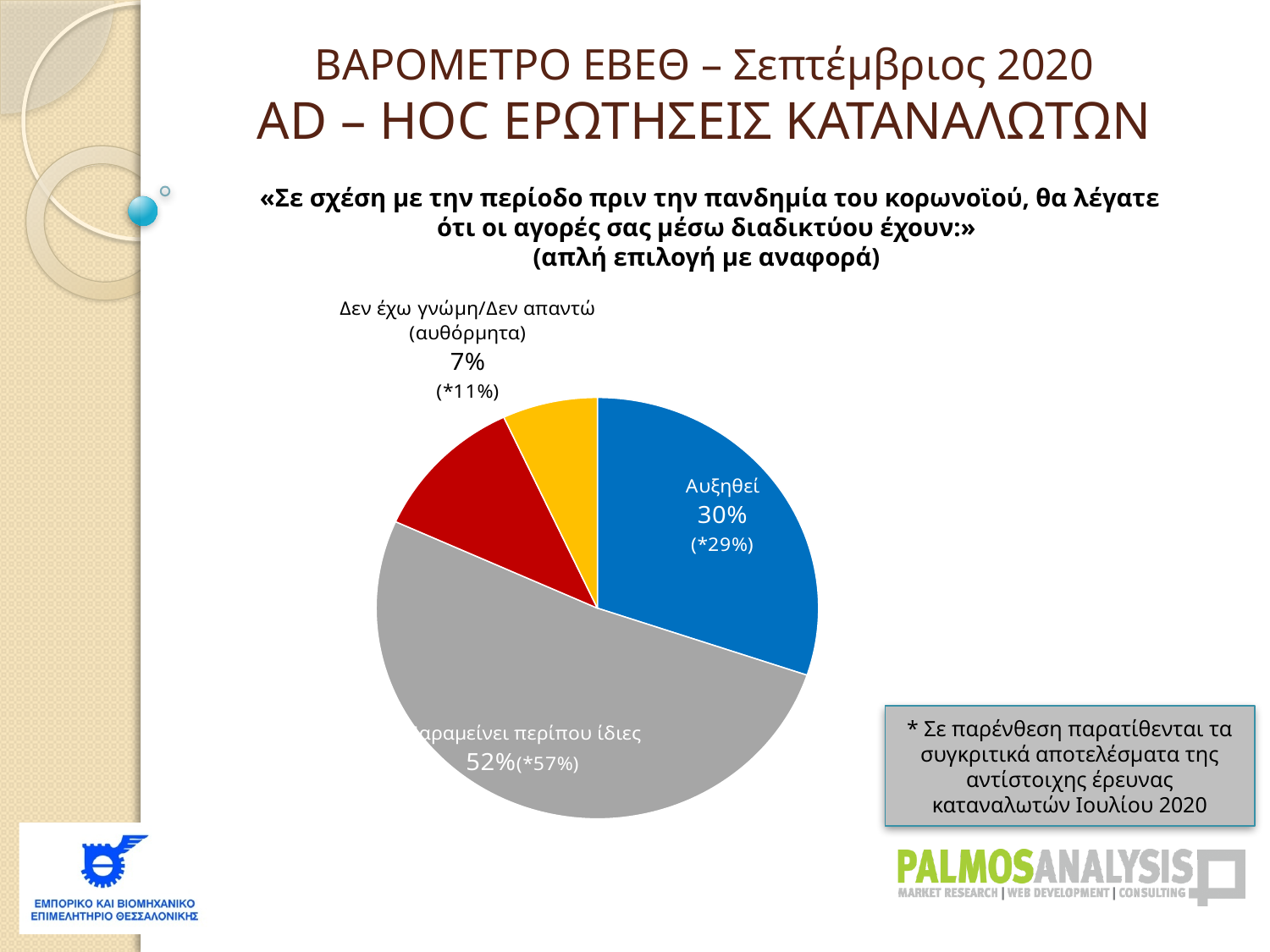
Which answer category has the largest share of the pie? Παραμείνει περίπου ίδιες What percentage of respondents answered «Παραμείνει περίπου ίδιες»? 52% By how many percentage points does «Παραμείνει περίπου ίδιες» exceed «Αυξηθεί»? 22 percentage points What percentage of respondents answered «Αυξηθεί» in the pie chart? 30% Which answer category has the smallest share of the pie? Δεν έχω γνώμη/Δεν απαντώ (αυθόρμητα) What kind of chart is shown on the slide? Pie chart What was the comparative July 2020 value shown in parentheses for «Παραμείνει περίπου ίδιες»? 57% What colour is the «Αυξηθεί» slice of the pie chart? Blue What was the comparative July 2020 value shown in parentheses for «Αυξηθεί»? 29% What was the comparative July 2020 value shown in parentheses for «Δεν έχω γνώμη/Δεν απαντώ (αυθόρμητα)»? 11% Which is larger: the share for «Αυξηθεί» or the share for «Δεν έχω γνώμη/Δεν απαντώ (αυθόρμητα)»? Αυξηθεί What percentage is shown for «Δεν έχω γνώμη/Δεν απαντώ (αυθόρμητα)»? 7%